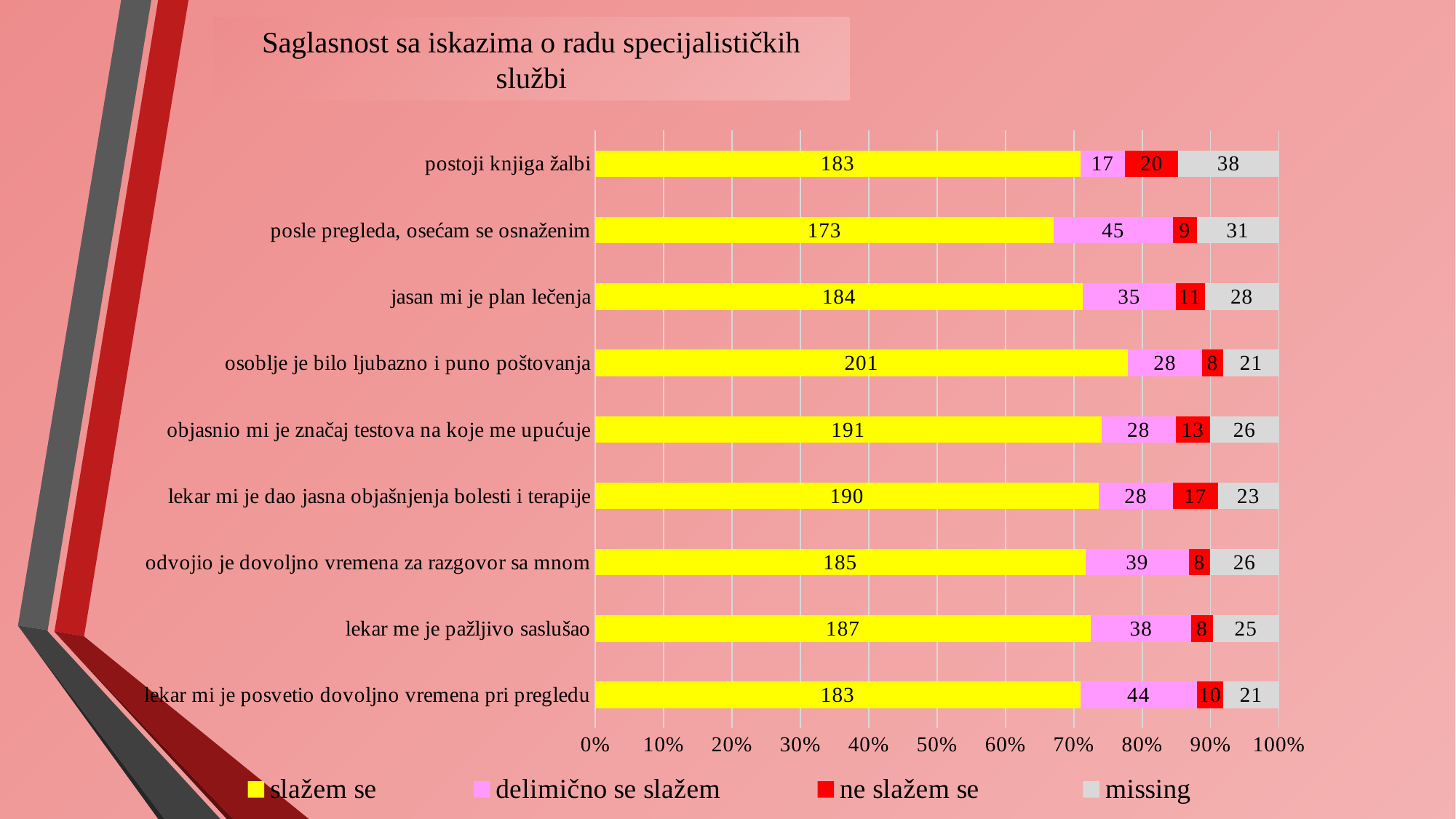
Which statement has the highest 'ne slažem se' value? postoji knjiga žalbi What is the 'delimično se slažem' value for 'posle pregleda, osećam se osnaženim'? 45 What is the 'missing' value for 'postoji knjiga žalbi'? 38 What kind of chart is shown on the slide? stacked bar chart How many series does the legend list? 4 Which statement has the lowest 'slažem se' value? posle pregleda, osećam se osnaženim How many categories (statements) are plotted on the chart? 9 What is the difference between the 'slažem se' values for 'objasnio mi je značaj testova na koje me upućuje' and 'lekar mi je dao jasna objašnjenja bolesti i terapije'? 1 What is the 'slažem se' value for 'osoblje je bilo ljubazno i puno poštovanja'? 201 Which statement has the highest 'slažem se' value? osoblje je bilo ljubazno i puno poštovanja What is the total of all four segments for 'jasan mi je plan lečenja'? 258 Which is larger: the 'ne slažem se' value for 'lekar mi je dao jasna objašnjenja bolesti i terapije' or for 'lekar me je pažljivo saslušao'? lekar mi je dao jasna objašnjenja bolesti i terapije